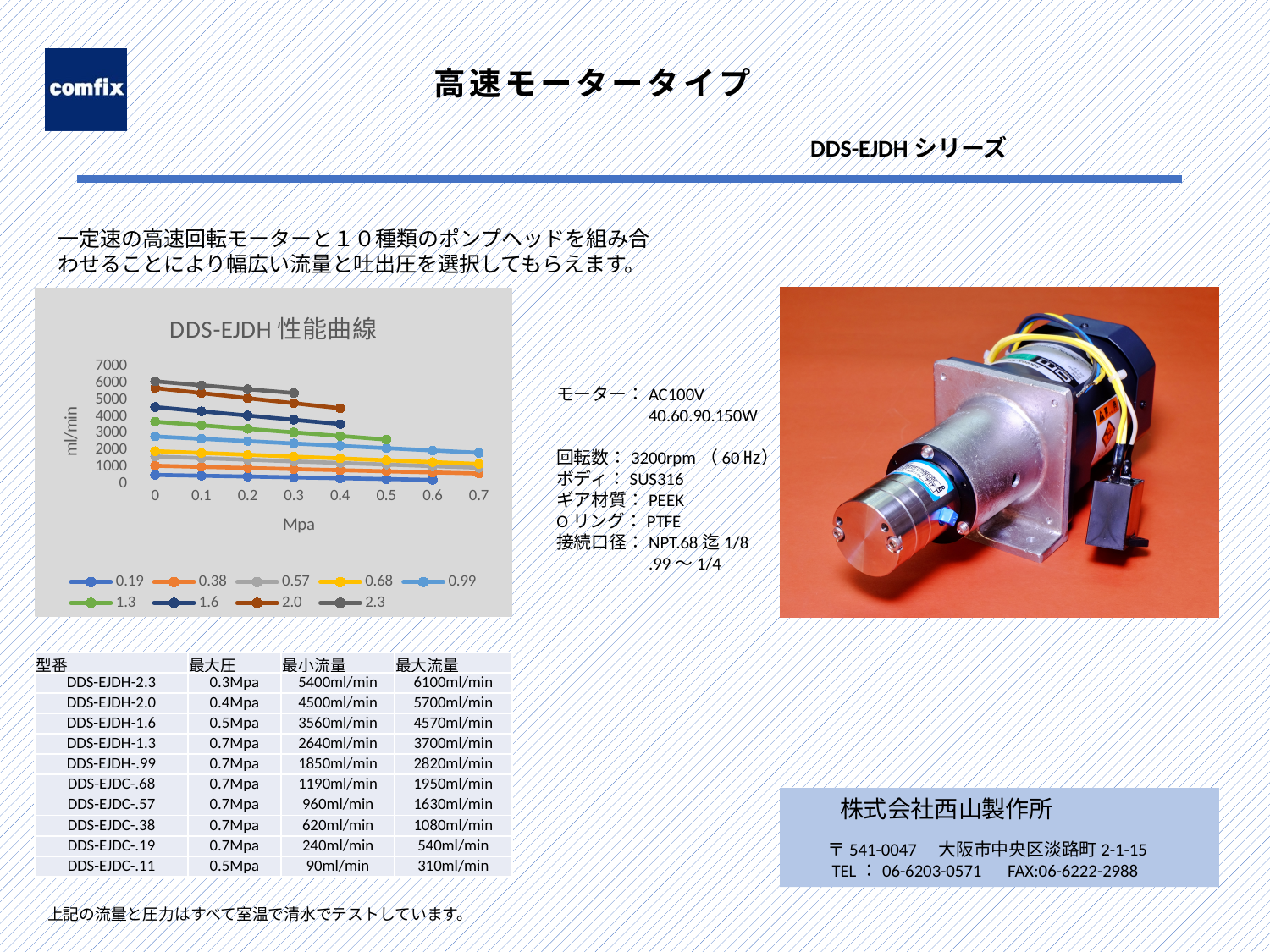
What is the label of the x axis on the DDS-EJDH 性能曲線 chart? Mpa At which Mpa value does the 2.3 series end in the DDS-EJDH 性能曲線 chart? 0.3 Which series has the highest flow values in the DDS-EJDH 性能曲線 chart? 2.3 Which series has the lowest flow values in the DDS-EJDH 性能曲線 chart? 0.19 What kind of chart is the DDS-EJDH 性能曲線 chart? line chart In the DDS-EJDH 性能曲線 chart, is the value of the 1.6 series at 0 Mpa greater or less than 4000? greater What is the label of the y axis on the DDS-EJDH 性能曲線 chart? ml/min How many series does the legend of the DDS-EJDH 性能曲線 chart list? 9 In the DDS-EJDH 性能曲線 chart, is the value of the 0.19 series at 0 Mpa greater or less than 1000? less In the DDS-EJDH 性能曲線 chart, do the flow values rise or fall as the pressure (Mpa) increases? fall In the DDS-EJDH 性能曲線 chart, is the value of the 2.0 series at 0 Mpa greater or less than 5000? greater In the DDS-EJDH 性能曲線 chart, which series has the larger value at 0 Mpa, 2.0 or 1.6? 2.0